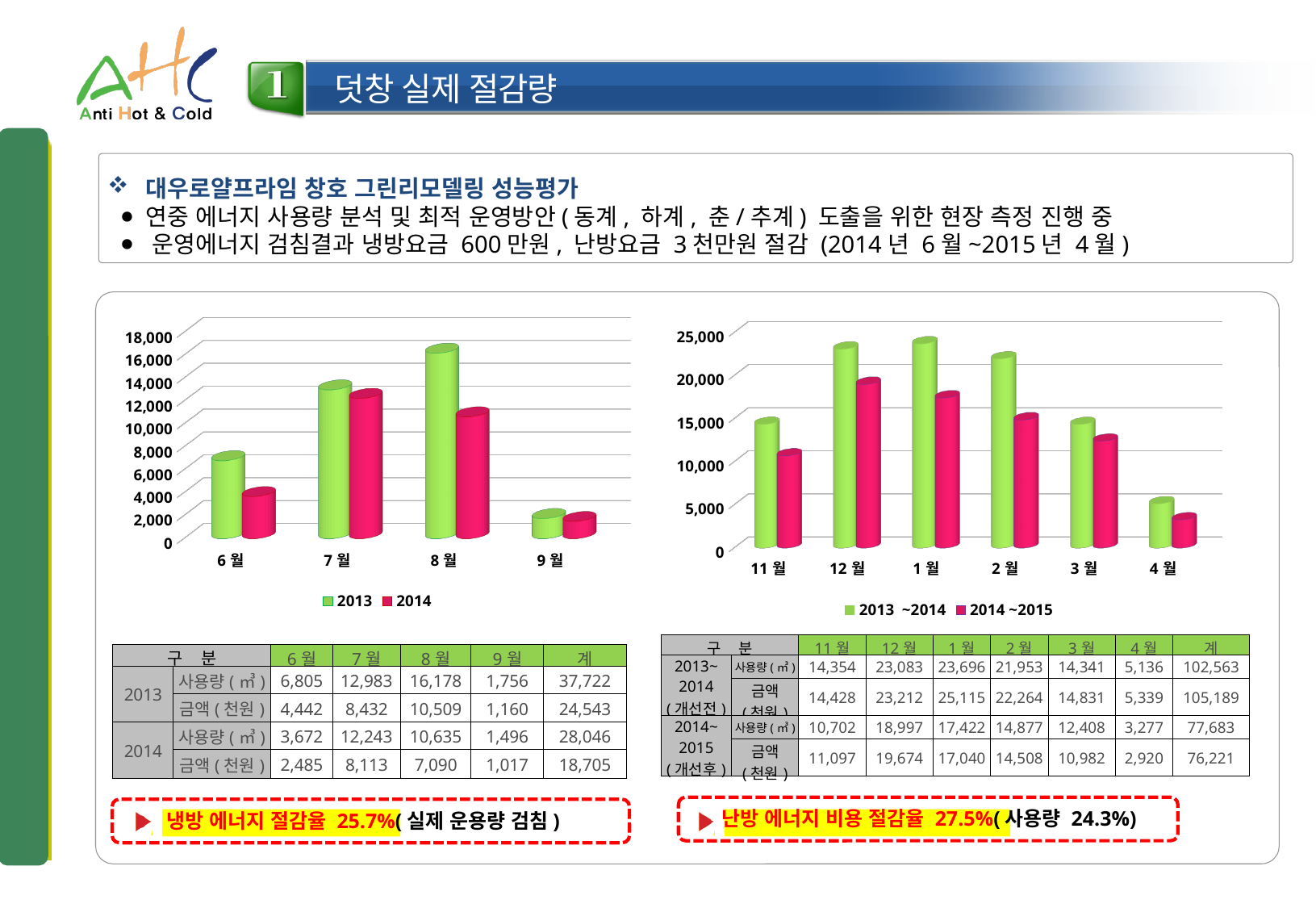
In the left chart (6월–9월), which series has the larger value for 8월, 2013 or 2014? 2013 How many month categories does the right chart (11월–4월) show? 6 In the left chart (6월–9월), is the 2013 value for 6월 greater or less than 8,000? less How many month categories does the left chart (6월–9월) show? 4 How many series does the legend of the left chart (6월–9월) list? 2 In the left chart (6월–9월), which month has the lowest 2013 value? 9월 What are the two legend entries of the right chart (11월–4월)? 2013~2014 and 2014~2015 What kind of chart is the left chart (6월–9월)? bar chart In the right chart (11월–4월), is the 2014~2015 value for 12월 greater or less than 15,000? greater According to the table under the left chart, what is the 2013 사용량 for 8월? 16,178 In the right chart (11월–4월), which month has the lowest 2013~2014 value? 4월 In the left chart (6월–9월), which month has the highest 2013 value? 8월